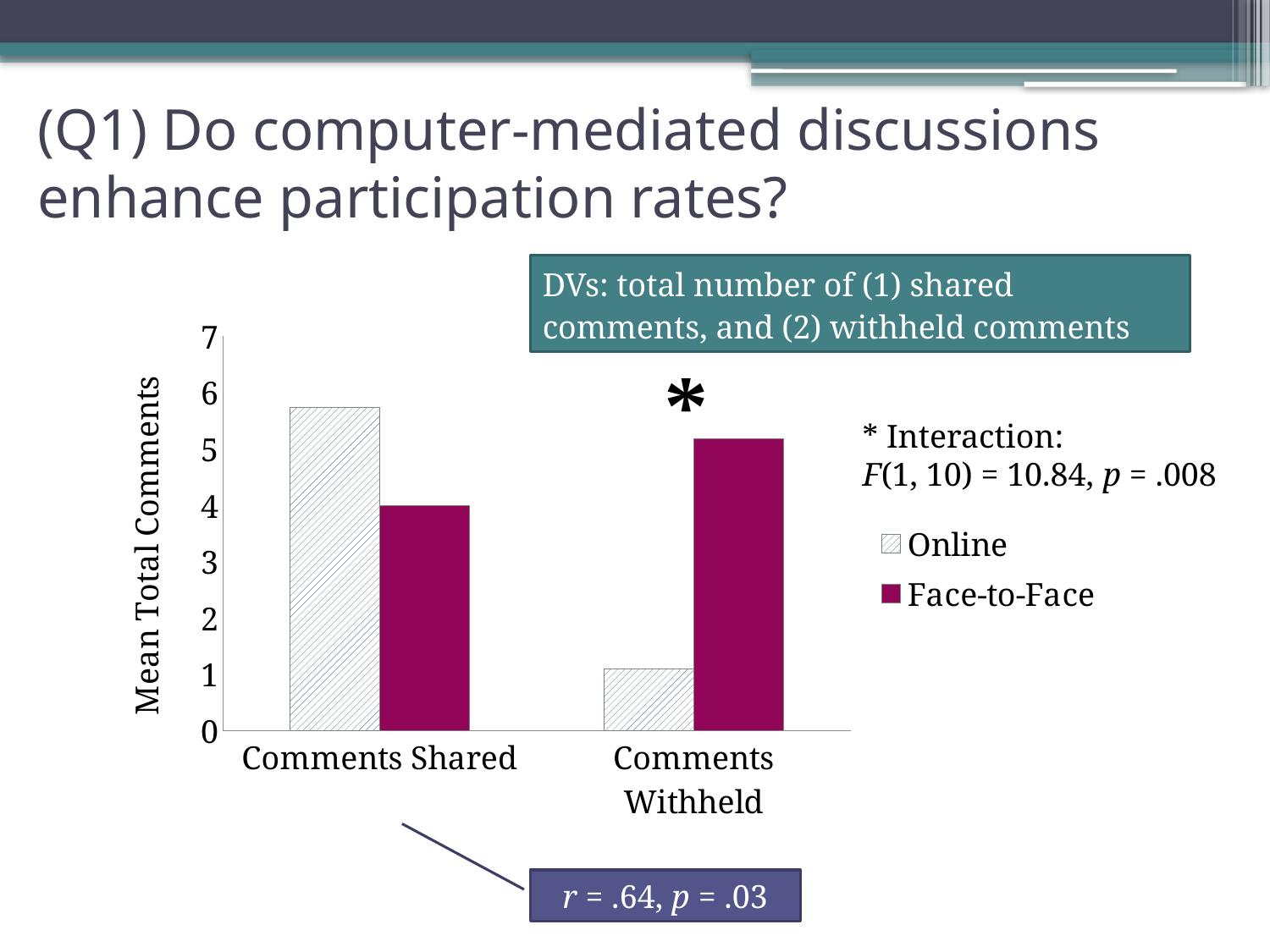
For Comments Shared, which series has the larger value, Online or Face-to-Face? Online Which bar in the chart is the highest? Online, Comments Shared Which bar in the chart is the lowest? Online, Comments Withheld What are the two series listed in the chart's legend? Online and Face-to-Face For Comments Withheld, which series has the larger value, Online or Face-to-Face? Face-to-Face How many categories are shown on the x axis of the chart? 2 Is the Online value for Comments Withheld greater or less than 2? less What kind of chart is shown on the slide? bar chart What is the label of the chart's y axis? Mean Total Comments How many series does the chart's legend list? 2 Is the Face-to-Face value for Comments Withheld greater or less than 4? greater Is the Online value for Comments Shared greater or less than 5? greater